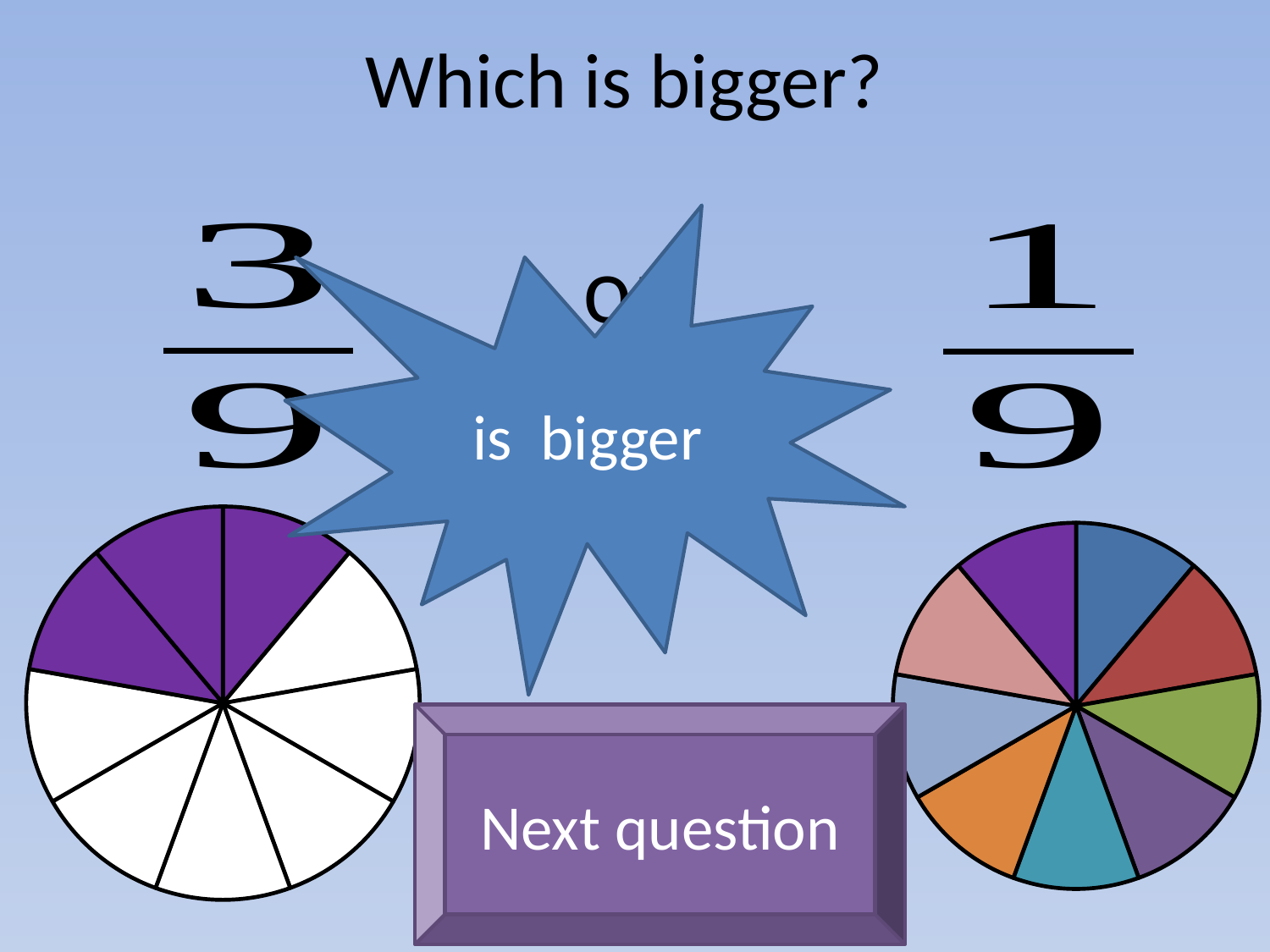
Which fraction shown on the slide is bigger, 3/9 or 1/9? 3/9 Which pie chart has the larger shaded purple portion, the left one or the right one? the left one How many charts are on the slide? 2 In the left pie chart, how many slices are left white? 6 What kind of chart is shown on the left side of the slide? pie chart In the left pie chart, how many slices are shaded purple? 3 What kind of chart is shown on the right side of the slide? pie chart What is the title of the slide containing the two pie charts? Which is bigger? What fraction of the left pie chart is shaded purple, as written on the slide? 3/9 What fraction of the right pie chart does a single slice represent, as written on the slide? 1/9